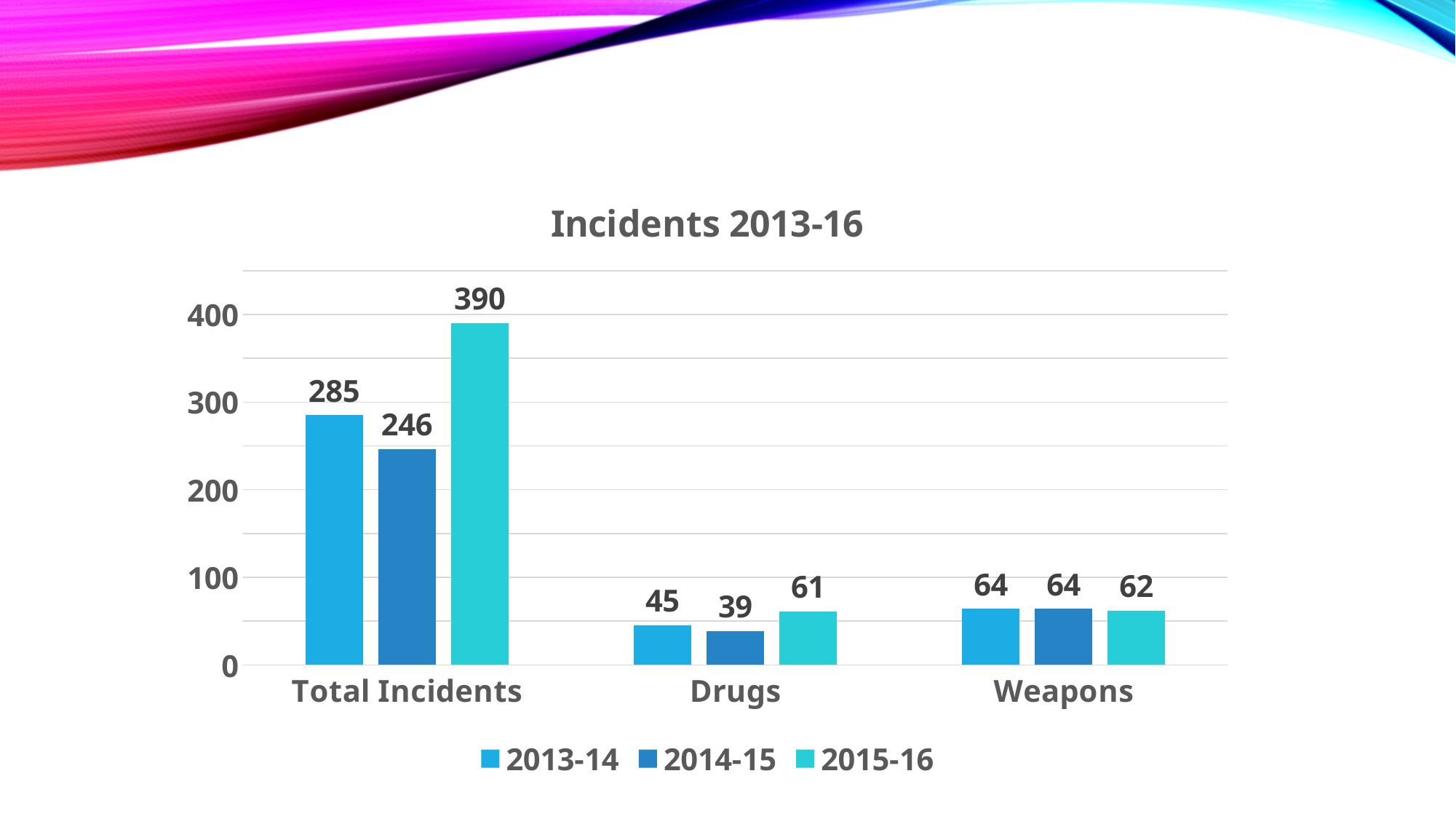
How many categories are shown on the x axis? 3 What is the value for Total Incidents in 2015-16? 390 Which year has the lowest value for Drugs? 2014-15 How many series does the legend list? 3 Which year has the highest value for Total Incidents? 2015-16 What is the title of the chart? Incidents 2013-16 What is the value for Weapons in 2013-14? 64 Is the value for Total Incidents in 2014-15 greater or less than 300? less What is the value for Drugs in 2014-15? 39 Which is larger: Drugs in 2013-14 or Drugs in 2015-16? Drugs in 2015-16 What is the difference between Total Incidents in 2015-16 and 2014-15? 144 What kind of chart is shown on the slide? bar chart